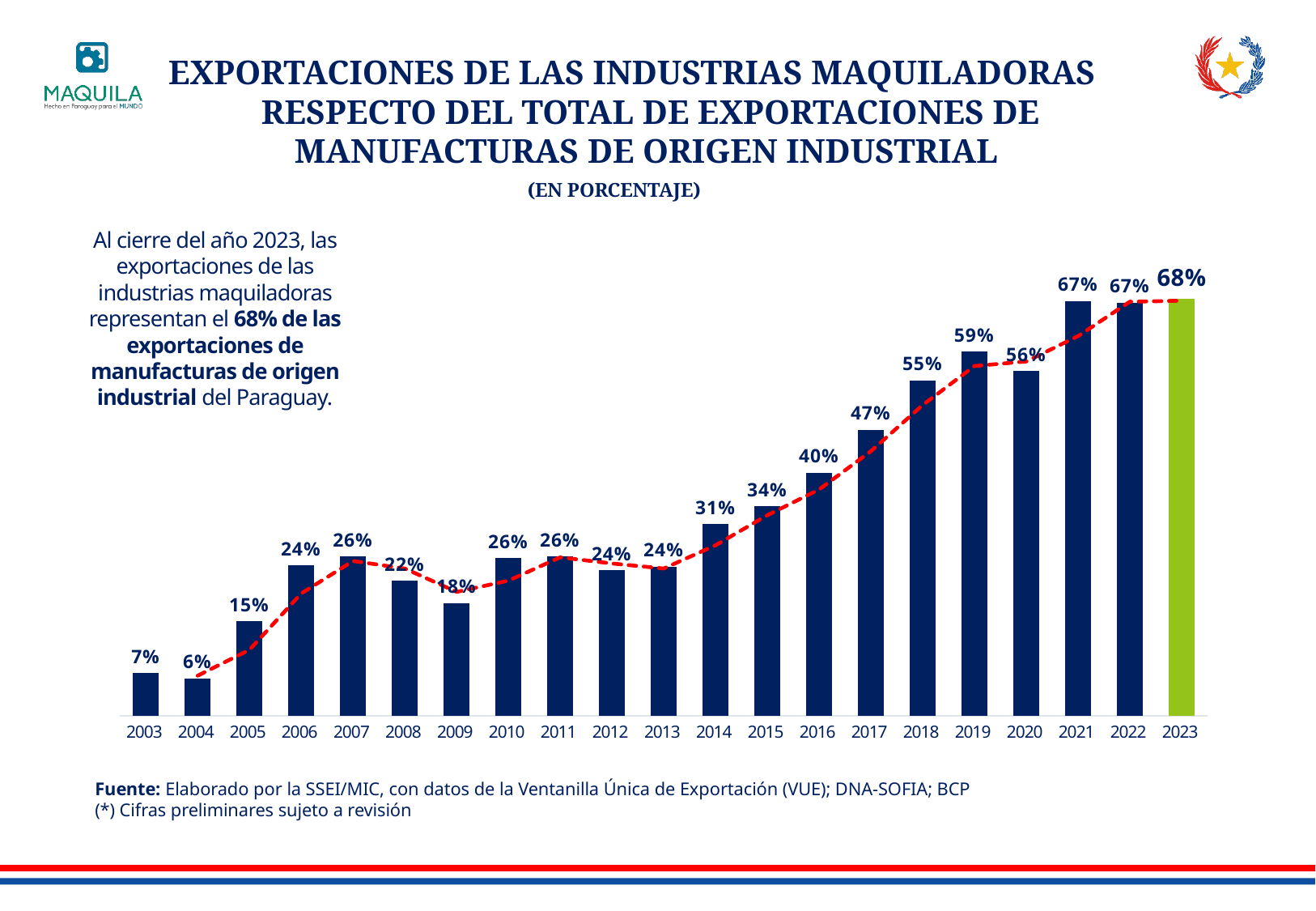
What kind of chart is shown on the slide? Bar chart Which bar is coloured green instead of dark blue? 2023 How many years are shown on the x axis? 21 Do the values generally rise or fall from 2013 to 2023? Rise What is the difference between the values for 2019 and 2020? 3% What is the value for 2023? 68% What is the difference between the values for 2023 and 2003? 61% Which year has the lowest value? 2004 Which year has the highest value? 2023 What is the value for 2016? 40% What is the value for 2009? 18% Which is larger, the value for 2008 or the value for 2010? 2010